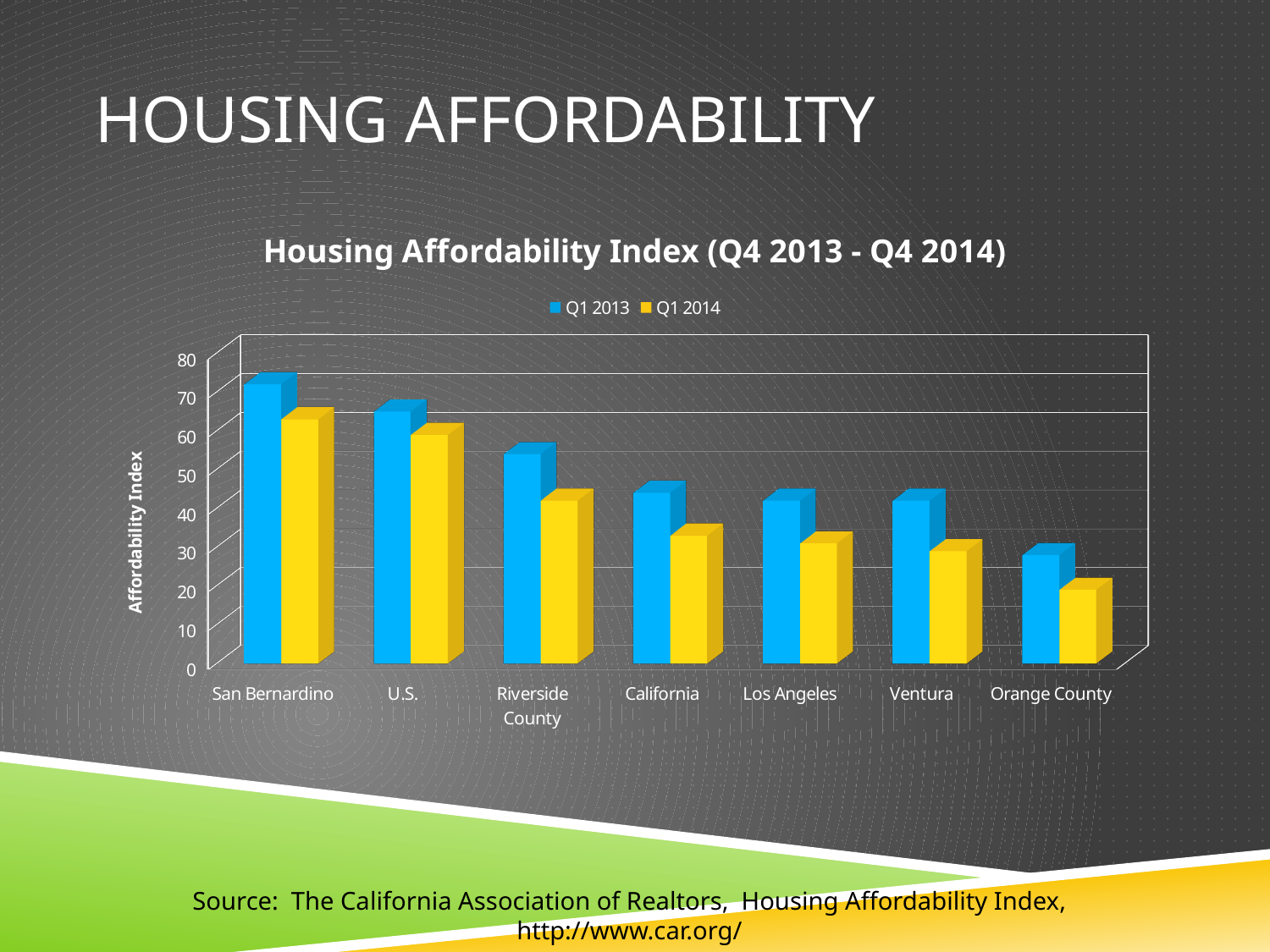
Which category has the lowest Q1 2014 value? Orange County Which category has the highest Q1 2013 value? San Bernardino How many categories are shown on the x axis? 7 Which category has the lowest Q1 2013 value? Orange County What is the title of the chart? Housing Affordability Index (Q4 2013 - Q4 2014) Is the Q1 2014 value for Orange County greater or less than 30? less What kind of chart is shown on the slide? Bar chart Do the Q1 2014 values generally rise or fall moving from left to right along the x axis? Fall Is the Q1 2013 value for San Bernardino greater or less than 60? greater Is the Q1 2014 value for California greater or less than 40? less Which is larger, the Q1 2013 value for San Bernardino or the Q1 2013 value for Riverside County? San Bernardino How many series does the legend list? 2